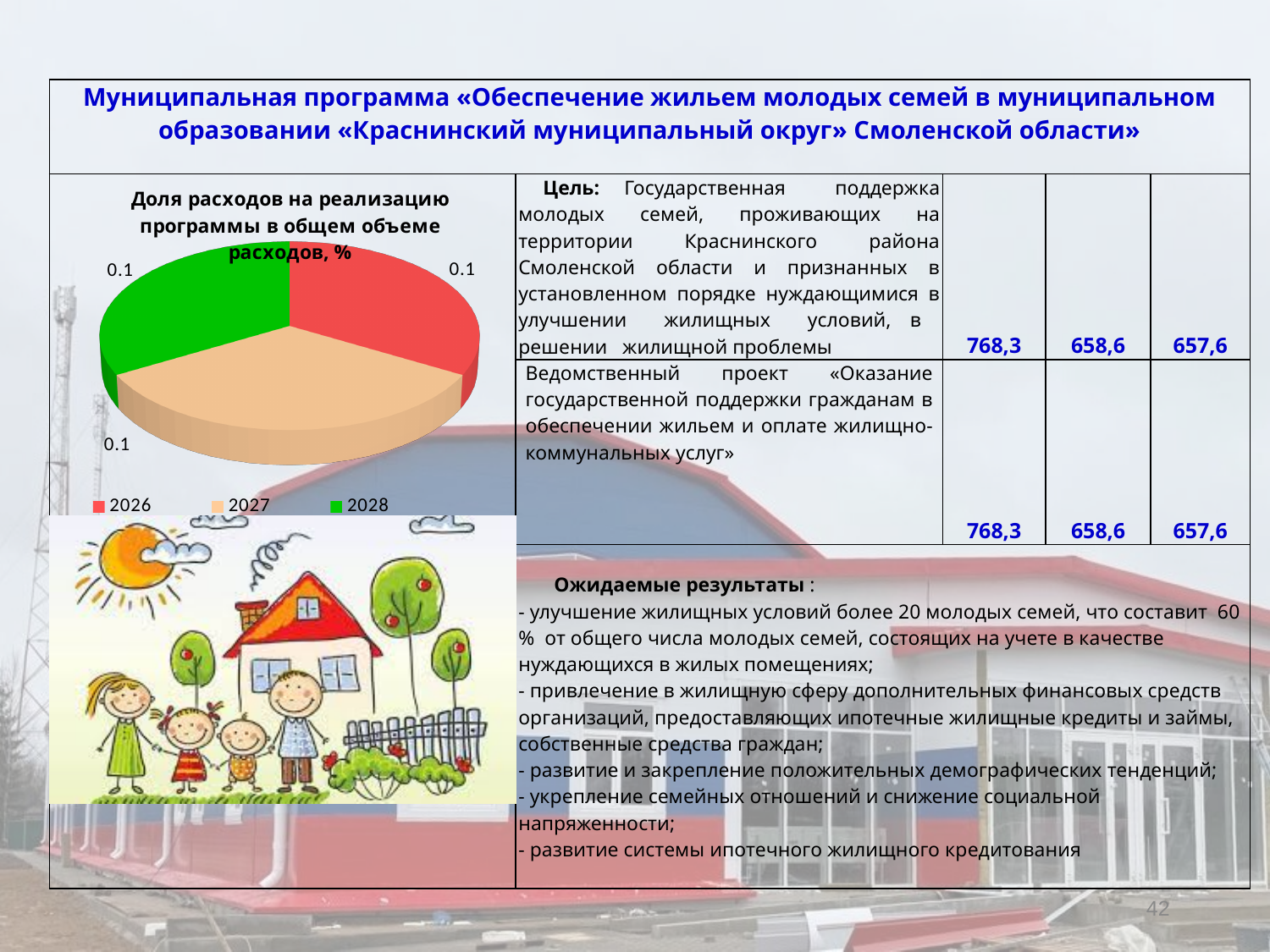
What is the value shown for 2026 in the pie chart? 0.1 What is the difference between the values for 2026 and 2028 in the pie chart? 0 How many slices does the pie chart have? 3 What is the value shown for 2027 in the pie chart? 0.1 How many entries does the legend of the pie chart list? 3 What colour is the slice for 2028 in the pie chart? green Is the value for 2026 in the pie chart the same as the value for 2027? yes, both are 0.1 What is the value shown for 2028 in the pie chart? 0.1 Which years are listed in the legend of the pie chart? 2026, 2027, 2028 What type of chart is shown on the slide? pie chart